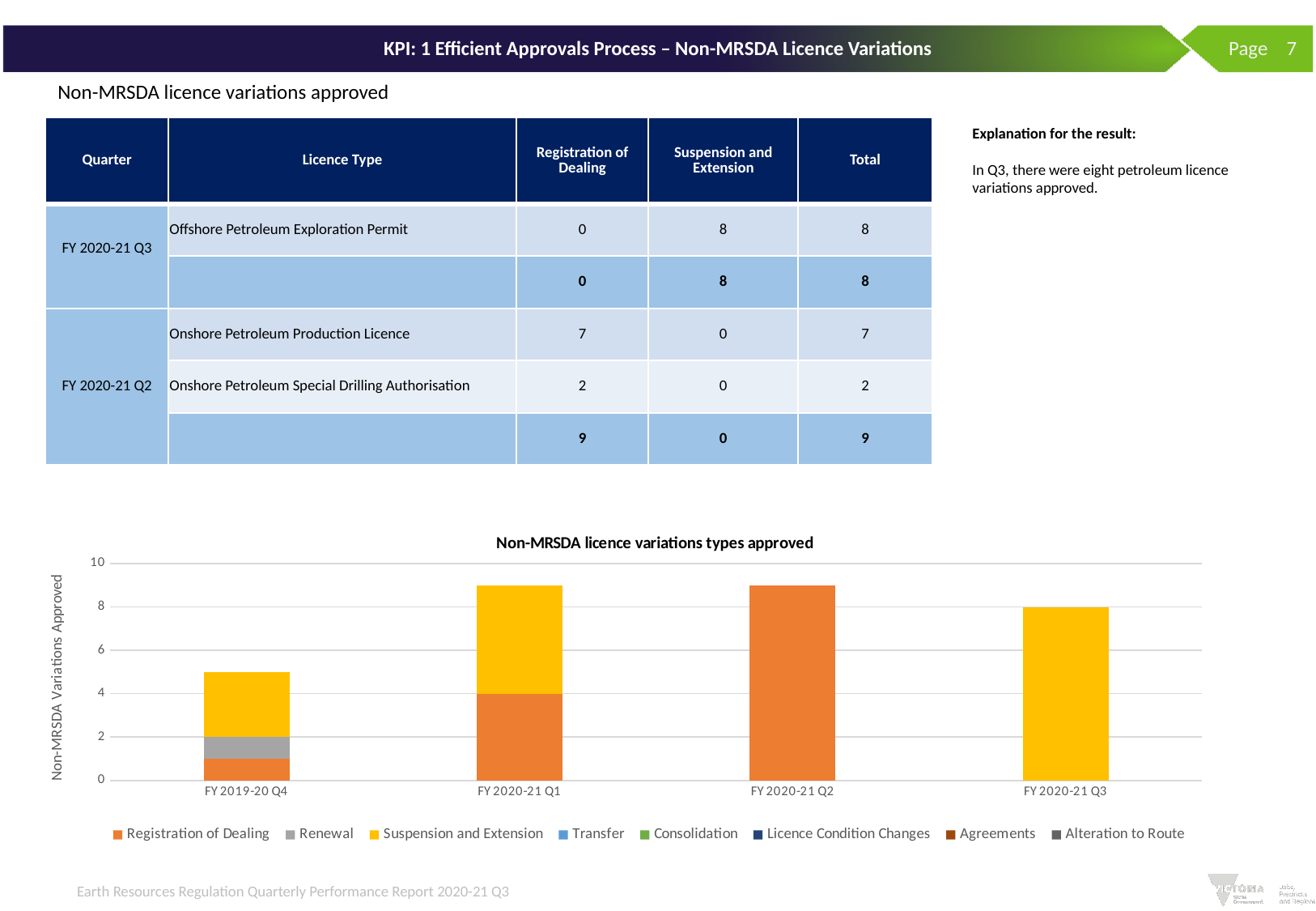
Is the total bar for FY 2019-20 Q4 greater or less than 6? less Is the Registration of Dealing segment for FY 2019-20 Q4 greater or less than 2? less What is the total height of the bar for FY 2020-21 Q3 in the chart? 8 Is the total bar for FY 2020-21 Q2 greater or less than 8? greater What is the value of the Registration of Dealing segment for FY 2020-21 Q1 in the chart? 4 How many quarters are shown on the x axis of the chart? 4 What kind of chart is shown under the title 'Non-MRSDA licence variations types approved'? Stacked bar chart Which quarter's bar in the chart consists only of Registration of Dealing? FY 2020-21 Q2 Which bar is taller in the chart, FY 2020-21 Q3 or FY 2019-20 Q4? FY 2020-21 Q3 How many series does the chart legend list? 8 What is the label on the y axis of the chart? Non-MRSDA Variations Approved Which quarter has the lowest total bar in the chart? FY 2019-20 Q4